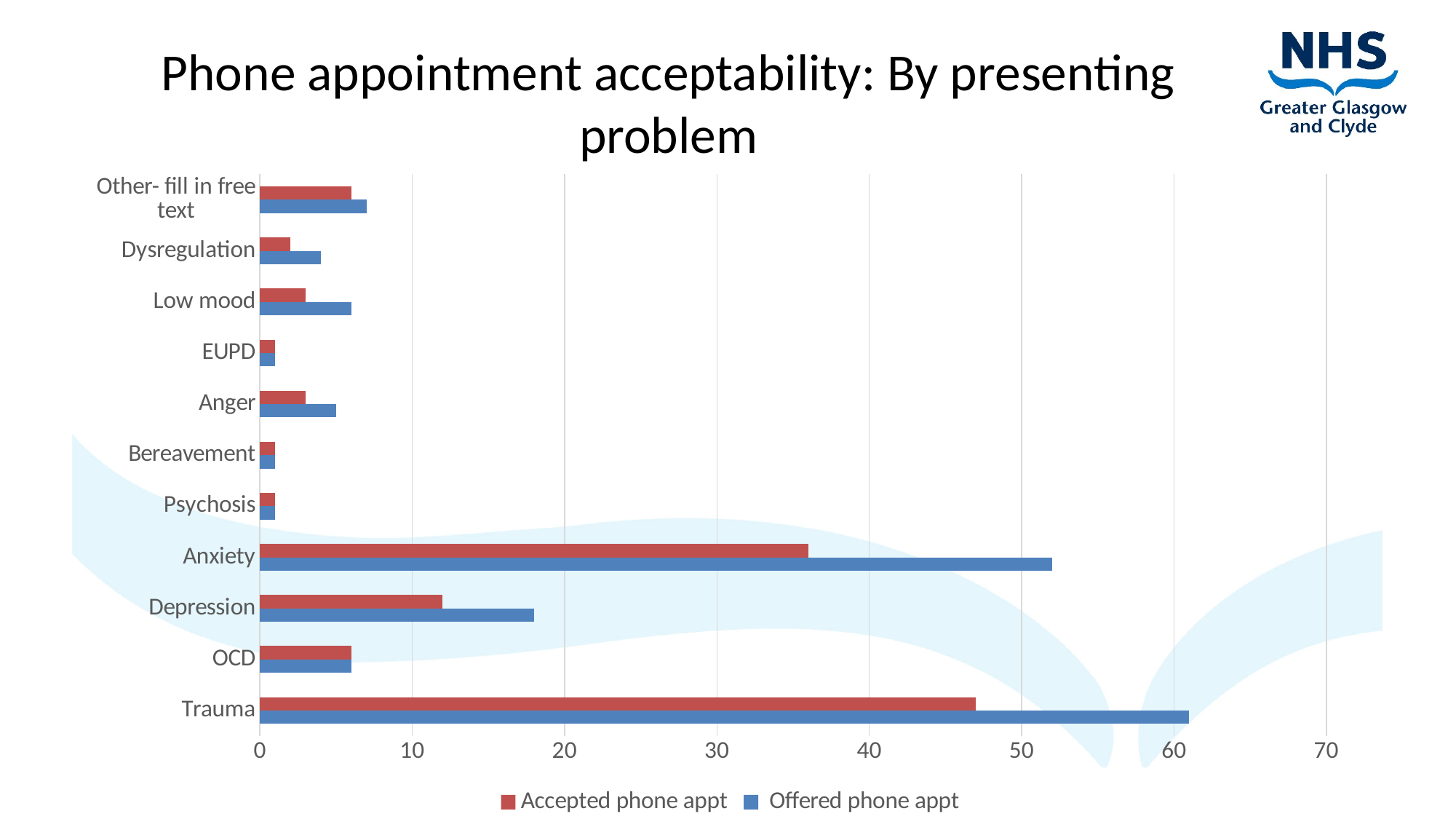
Is the Accepted phone appt value for Trauma greater or less than 50? less How many presenting problem categories are shown on the chart? 11 Which is larger: the Offered phone appt value for Anxiety or for Depression? Anxiety How many series does the legend list? 2 Which is larger for Trauma: Accepted phone appt or Offered phone appt? Offered phone appt Is the Accepted phone appt value for Anxiety greater or less than 40? less Which presenting problem has the highest value for Offered phone appt? Trauma Is the Offered phone appt value for Depression greater or less than 20? less What is the title of the chart? Phone appointment acceptability: By presenting problem Which presenting problem has the highest value for Accepted phone appt? Trauma What kind of chart is shown on the slide? bar chart